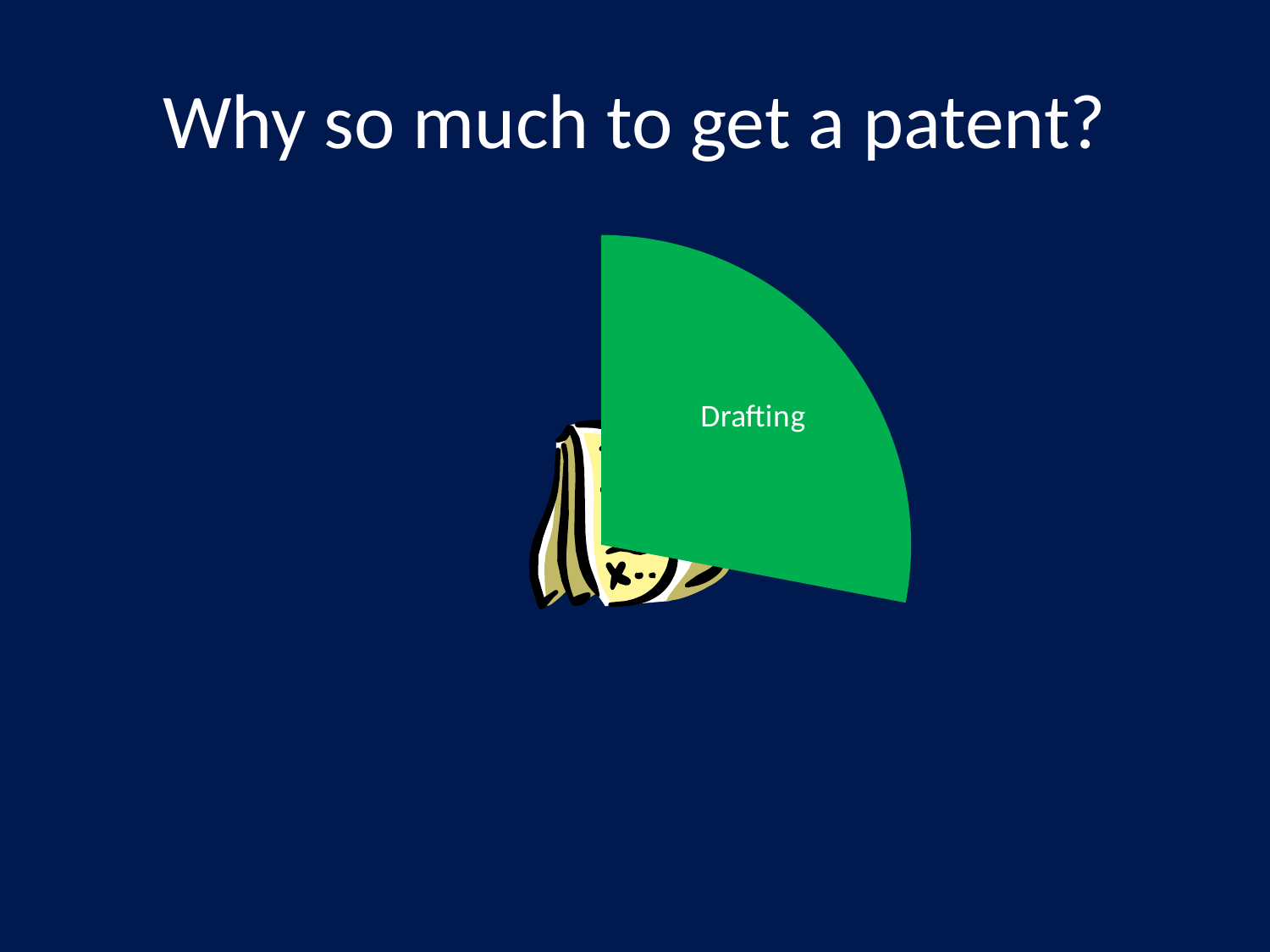
What is the label of the visible slice of the pie chart? Drafting What colour is the Drafting slice of the pie chart? green What kind of chart is shown on the slide? pie chart How many labelled slices are visible in the pie chart? 1 What is the title of the slide containing the pie chart? Why so much to get a patent?